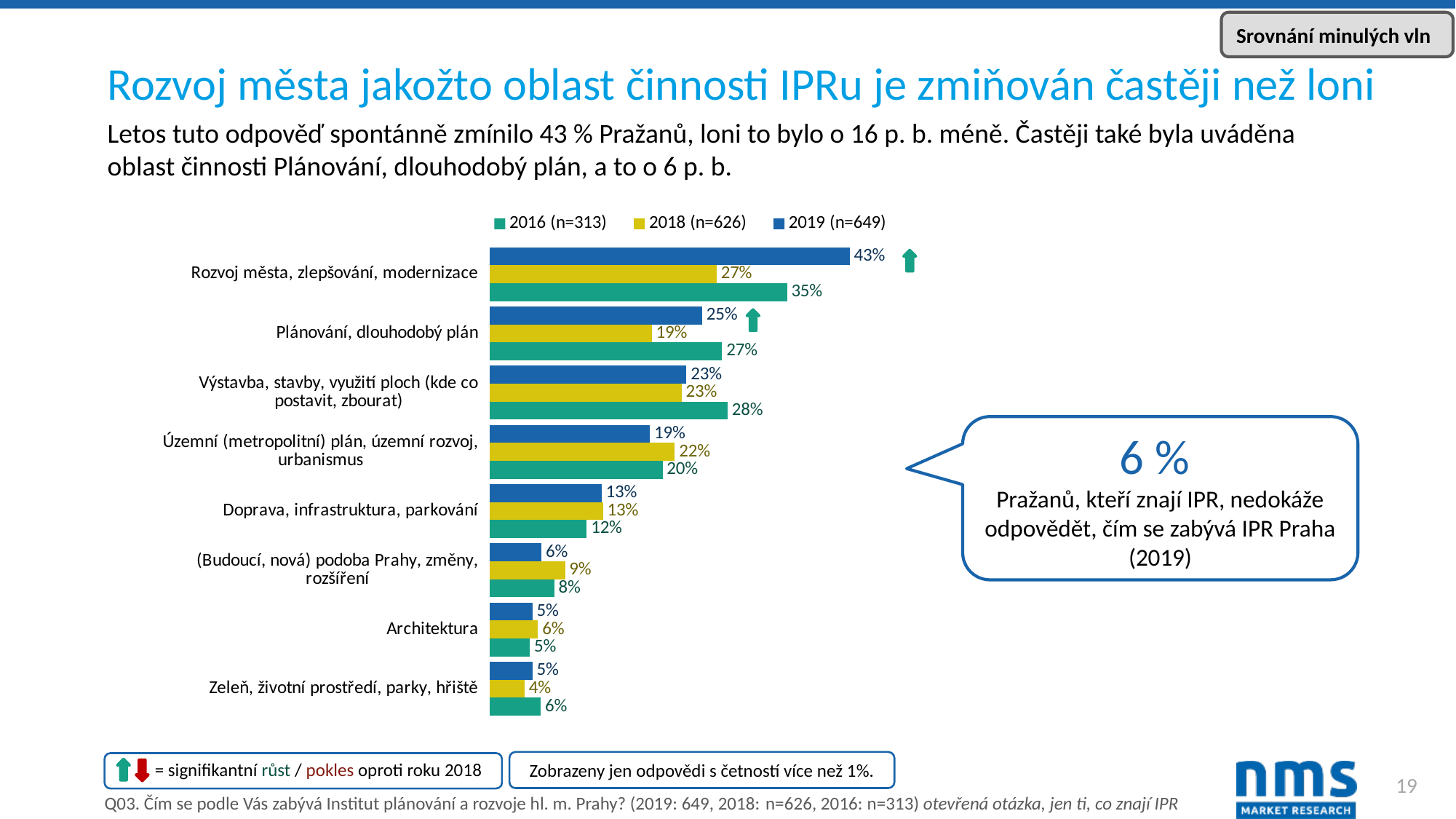
What is the 2019 (n=649) value for 'Doprava, infrastruktura, parkování'? 13% How many categories are shown in the chart? 8 How many series does the legend list? 3 Which category has the highest 2019 (n=649) value? Rozvoj města, zlepšování, modernizace Which series is shown in dark blue in the chart? 2019 (n=649) What kind of chart is shown on the slide? bar chart What is the 2019 (n=649) value for 'Rozvoj města, zlepšování, modernizace'? 43% What is the 2018 (n=626) value for 'Plánování, dlouhodobý plán'? 19% What is the 2016 (n=313) value for 'Výstavba, stavby, využití ploch (kde co postavit, zbourat)'? 28% Which category has the lowest 2018 (n=626) value? Zeleň, životní prostředí, parky, hřiště For 'Územní (metropolitní) plán, územní rozvoj, urbanismus', which is larger: the 2018 (n=626) value or the 2019 (n=649) value? 2018 (n=626) What is the difference between the 2019 (n=649) and 2018 (n=626) values for 'Rozvoj města, zlepšování, modernizace'? 16 p. b.